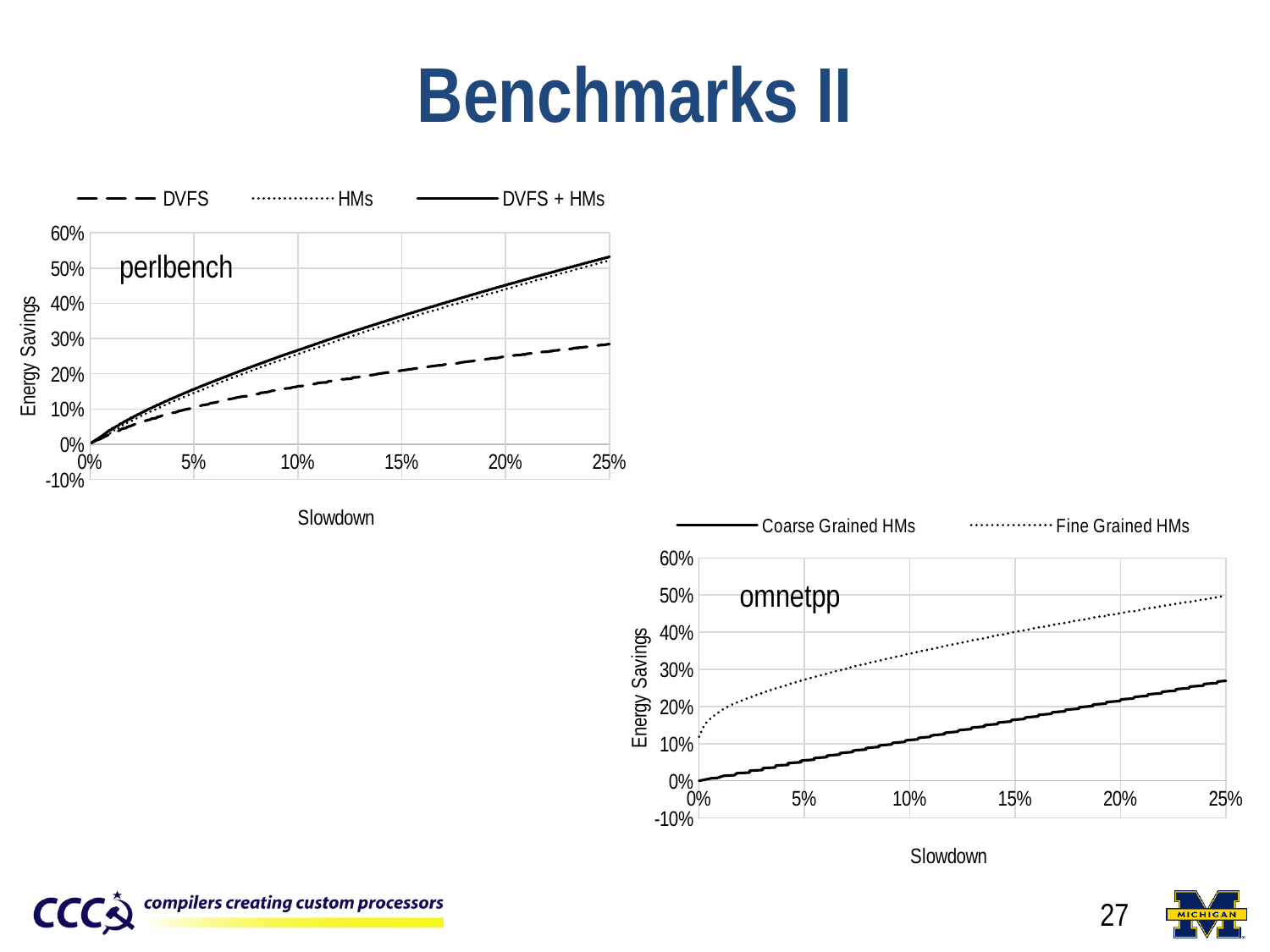
How many series does the legend of the omnetpp chart list? 2 What kind of chart is the omnetpp chart? line chart How many series does the legend of the perlbench chart list? 3 In the perlbench chart, at 25% Slowdown, which series has the higher Energy Savings: DVFS or DVFS + HMs? DVFS + HMs In the omnetpp chart, is the Energy Savings value for Coarse Grained HMs at 25% Slowdown greater or less than 40%? less What kind of chart is the perlbench chart? line chart In the perlbench chart, does the DVFS + HMs line rise or fall as Slowdown increases? rise In the perlbench chart, is the Energy Savings value for DVFS at 25% Slowdown greater or less than 40%? less In the omnetpp chart, at 10% Slowdown, which series has the higher Energy Savings: Coarse Grained HMs or Fine Grained HMs? Fine Grained HMs In the perlbench chart, is the Energy Savings value for DVFS + HMs at 25% Slowdown greater or less than 40%? greater In the omnetpp chart, does the Coarse Grained HMs line rise or fall as Slowdown increases? rise